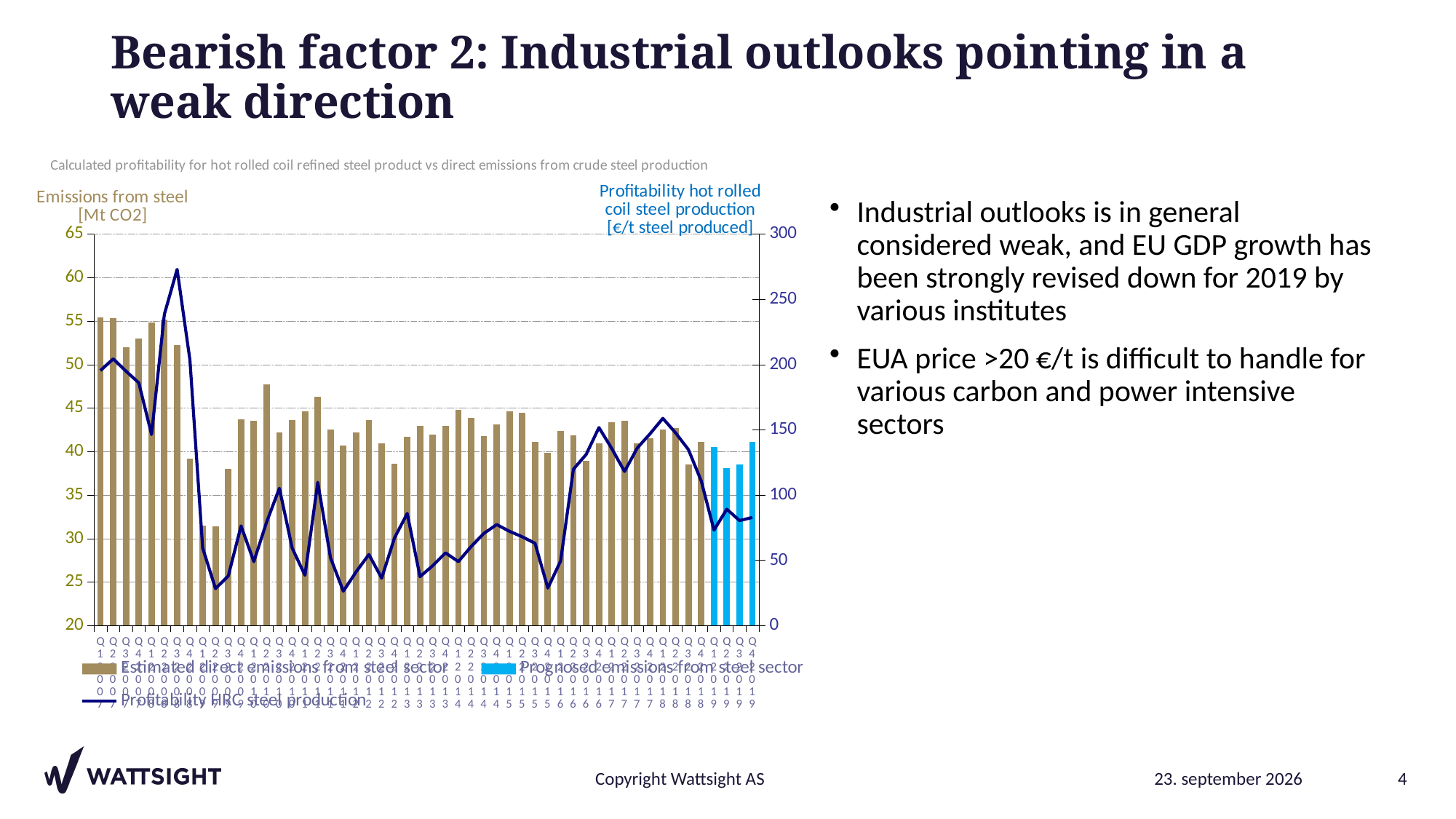
How many light blue bars (prognosed emissions from steel sector) are plotted in the chart? 4 Is the tallest brown estimated emissions bar greater or less than 50 Mt CO2? greater What is the maximum value shown on the right-hand profitability axis? 300 Does the profitability line rise or fall between its peak near the start of the series and the following quarters? fall Is the highest value of the profitability line greater or less than 250 €/t? greater What is the title of the left vertical axis of the chart? Emissions from steel [Mt CO2] Which series is drawn as a line in the chart? Profitability HRC steel production What is the minimum value shown on the left-hand emissions axis? 20 Is the first light blue prognosed emissions bar greater or less than 35 Mt CO2? greater How many series does the chart legend list? 3 What kind of chart is shown on the slide? A combination bar and line chart